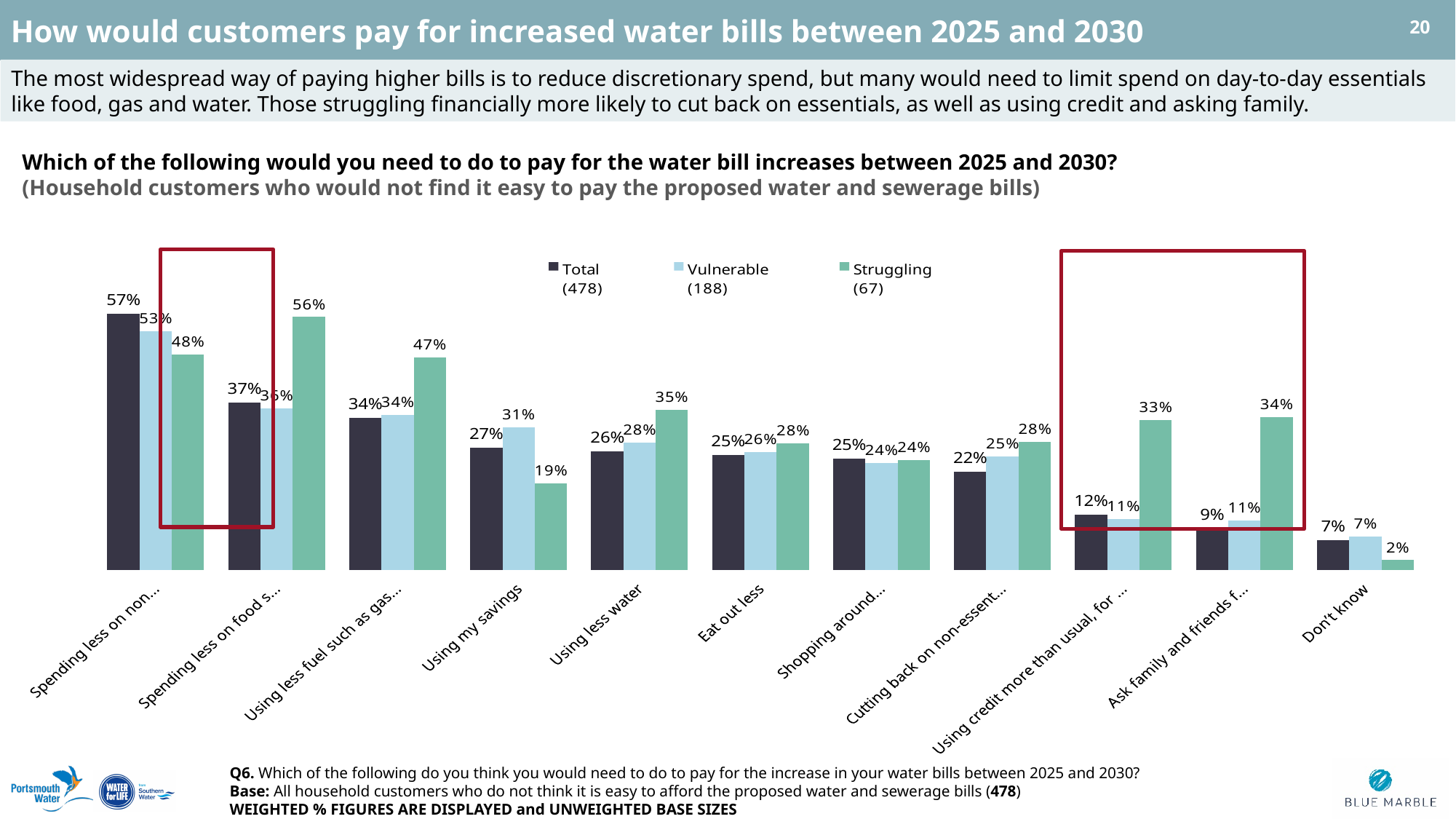
What is the Total value for Using my savings? 27% What is the base size shown in the legend for the Struggling series? 67 How many series does the legend list? 3 Which category has the highest Total value? Spending less on non... What is the Struggling value for Don't know? 2% For Using my savings, which is larger: the Vulnerable value or the Struggling value? Vulnerable What is the Vulnerable value for Eat out less? 26% How many categories are shown on the x axis? 11 What kind of chart is shown on the slide? Bar chart What is the difference between the Struggling and Total values for Using less water? 9 percentage points Which category has the lowest Struggling value? Don't know What is the Struggling value for Using less water? 35%